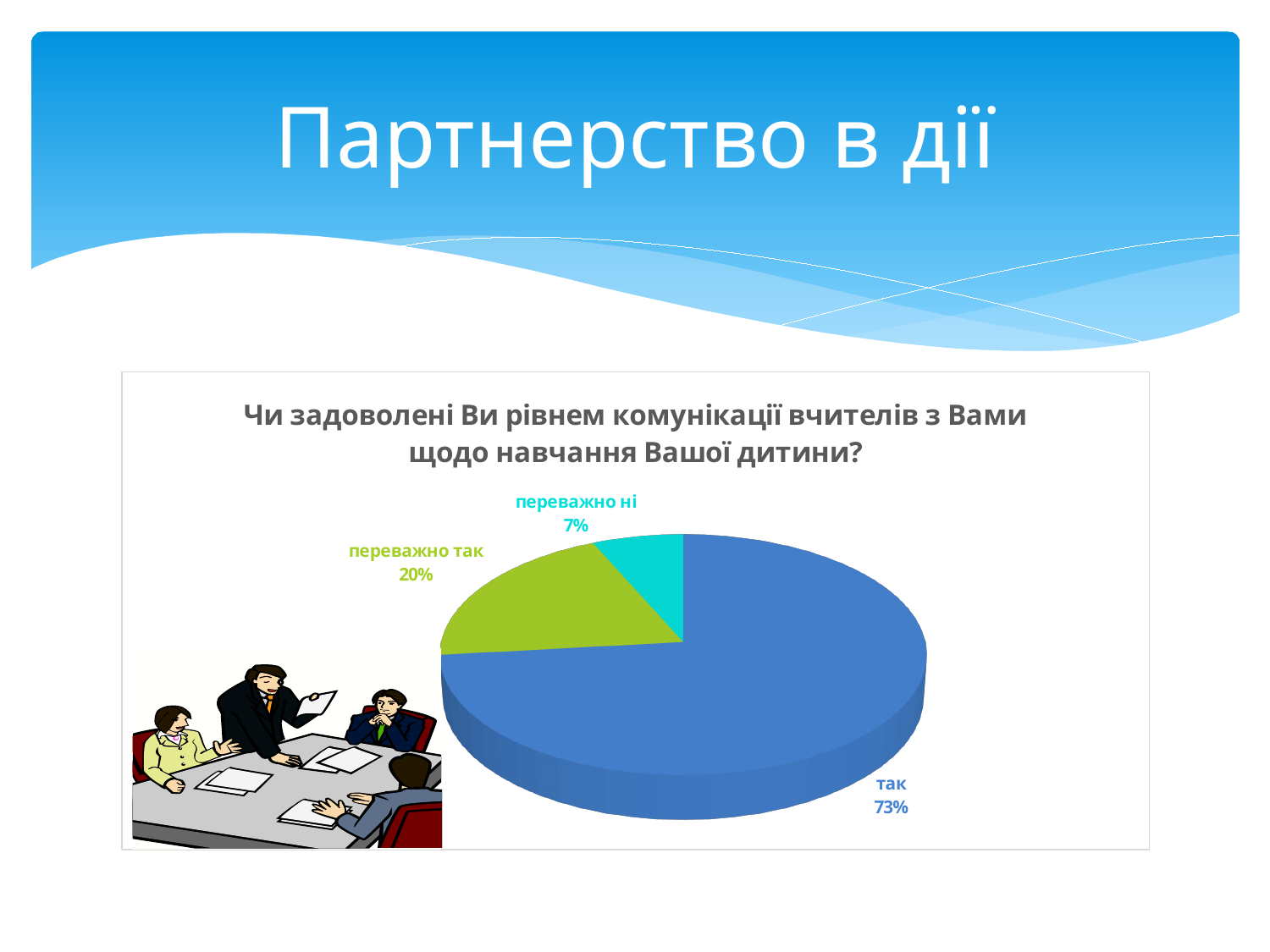
Which is larger, the share for "переважно так" or the share for "переважно ні"? переважно так What colour is the slice for "так"? blue What is the share for "так"? 73% How many slices does the pie chart have? 3 What is the title of the chart? Чи задоволені Ви рівнем комунікації вчителів з Вами щодо навчання Вашої дитини? What is the difference in percentage points between "так" and "переважно так"? 53% Which category has the smallest slice of the pie? переважно ні What is the difference in percentage points between "переважно так" and "переважно ні"? 13% Which category has the largest slice of the pie? так What kind of chart is shown on the slide? pie chart What is the share for "переважно так"? 20% What is the share for "переважно ні"? 7%